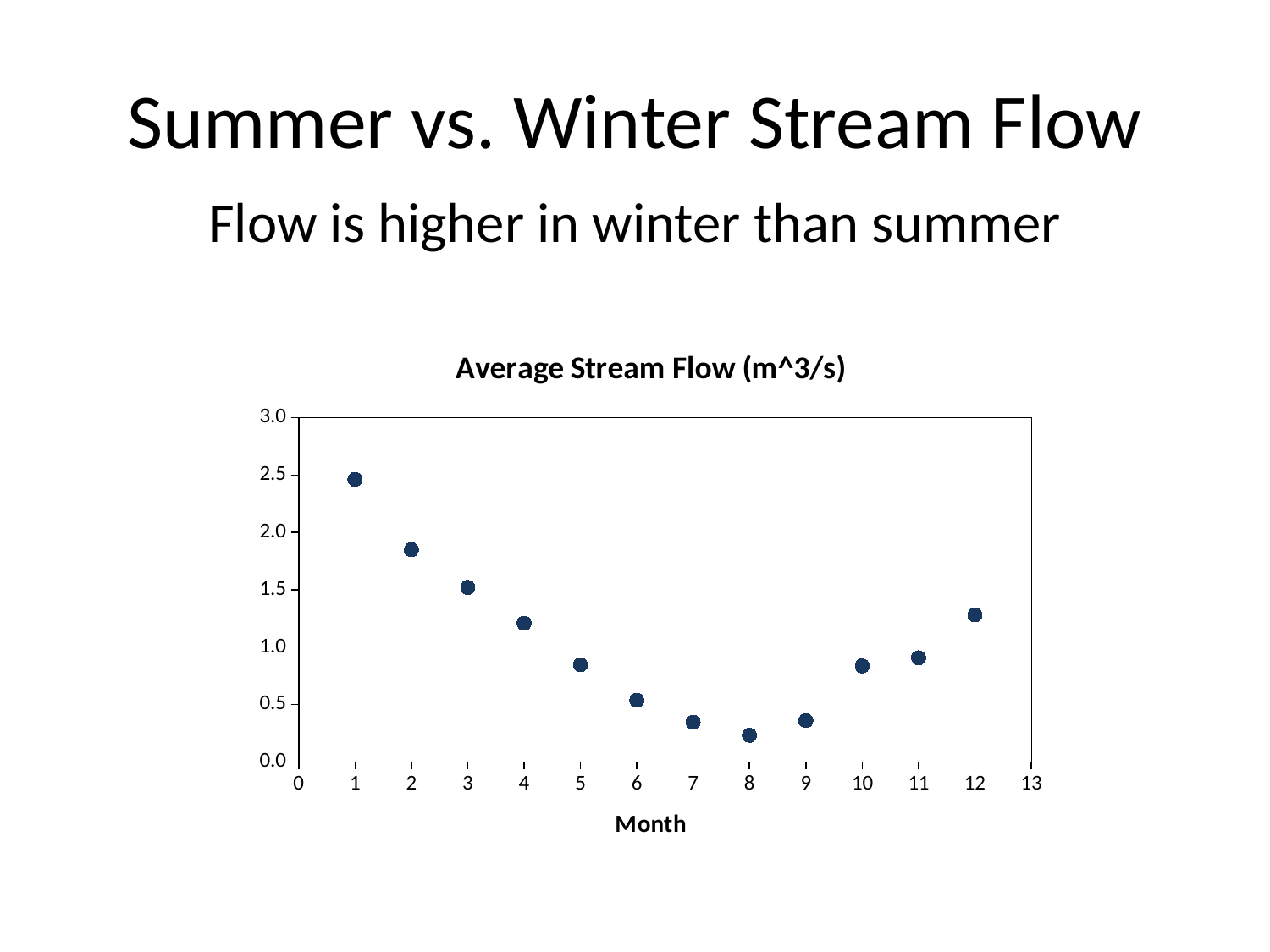
What kind of chart is shown on the slide? Scatter plot Which month has the lowest average stream flow? Month 8 How do the values change from month 1 to month 8? They fall Is the value for month 6 greater or less than 1.0? less Which has a higher average stream flow, month 1 or month 12? Month 1 Is the value for month 8 greater or less than 0.5? less Is the value for month 12 greater or less than 1.0? greater How many data points are plotted on the chart? 12 Which month has the highest average stream flow? Month 1 What is the title of the chart? Average Stream Flow (m^3/s)